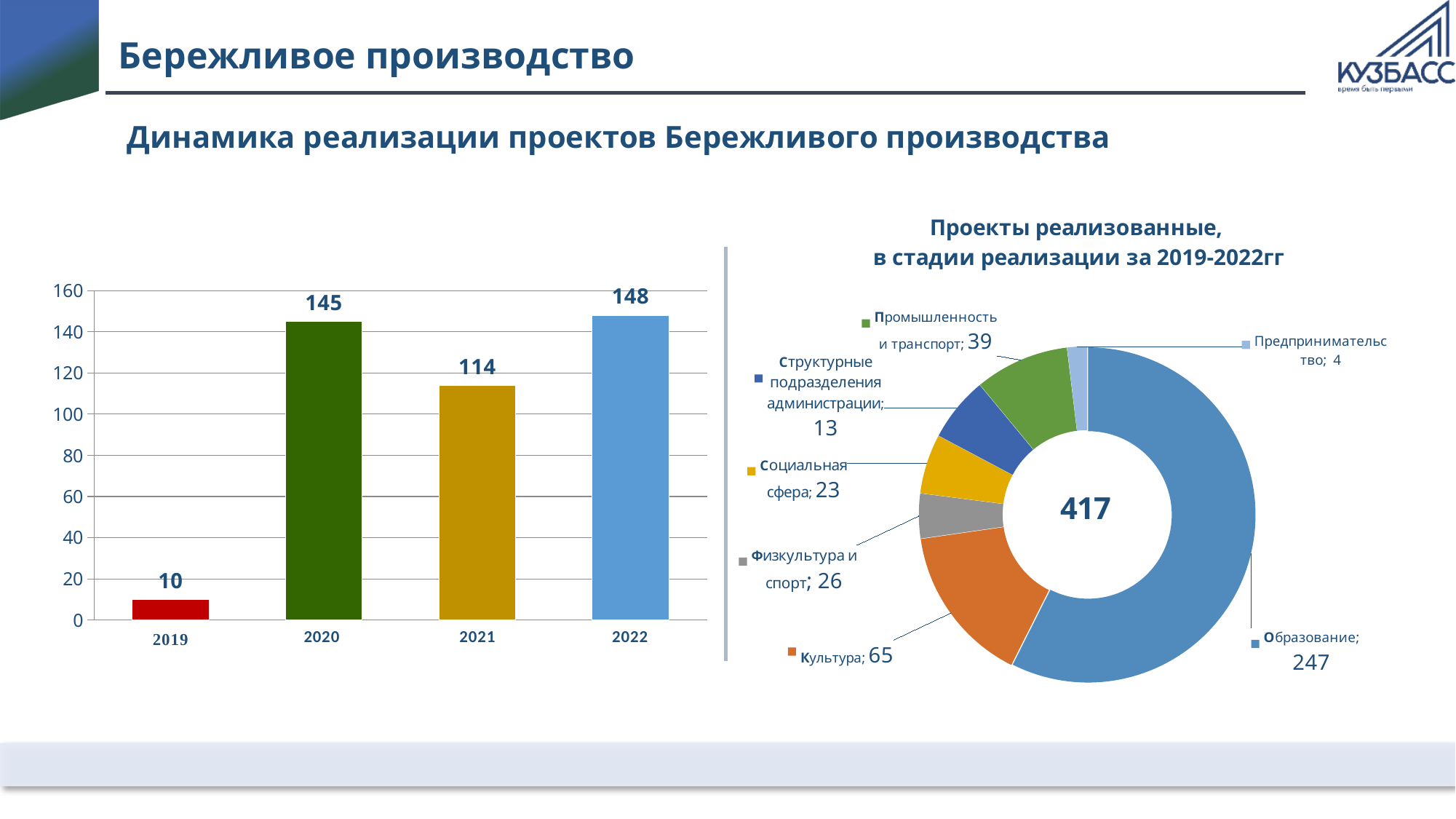
In the chart titled 'Проекты реализованные, в стадии реализации за 2019-2022гг', what total is shown in the centre of the doughnut? 417 In the chart titled 'Проекты реализованные, в стадии реализации за 2019-2022гг', what is the value for Культура? 65 In the left bar chart, what is the value for 2021? 114 In the left bar chart, which year has the lowest value? 2019 In the chart titled 'Проекты реализованные, в стадии реализации за 2019-2022гг', how many categories are shown? 7 In the left bar chart, which is larger: the value for 2020 or the value for 2022? 2022 In the left bar chart, which year has the highest value? 2022 In the chart titled 'Проекты реализованные, в стадии реализации за 2019-2022гг', which category has the largest value? Образование In the left bar chart, how many years are shown? 4 In the left bar chart, what is the difference between the values for 2020 and 2021? 31 In the chart titled 'Проекты реализованные, в стадии реализации за 2019-2022гг', which category has the smallest value? Предпринимательство What kind of chart is the chart on the left side of the slide? Bar chart